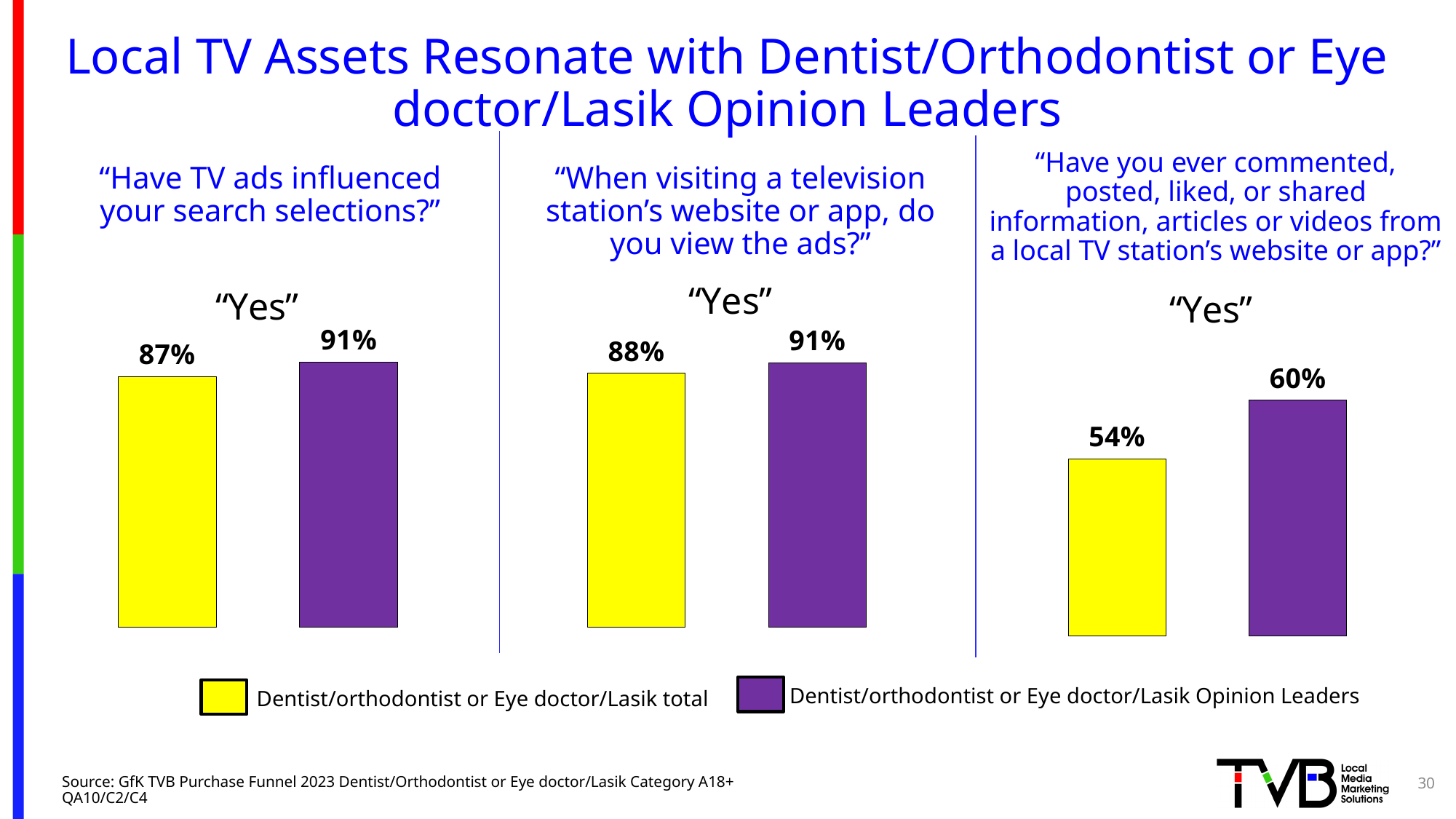
In the right chart ("Have you ever commented, posted, liked, or shared..."), what is the value for Dentist/orthodontist or Eye doctor/Lasik total? 54% In the middle chart ("When visiting a television station's website or app, do you view the ads?"), which group has the larger value: total or Opinion Leaders? Opinion Leaders In the middle chart ("When visiting a television station's website or app, do you view the ads?"), what is the value for Dentist/orthodontist or Eye doctor/Lasik total? 88% In the right chart ("Have you ever commented, posted, liked, or shared..."), which group has the lower value? Dentist/orthodontist or Eye doctor/Lasik total In the middle chart ("When visiting a television station's website or app, do you view the ads?"), what is the value for Dentist/orthodontist or Eye doctor/Lasik Opinion Leaders? 91% In the left chart ("Have TV ads influenced your search selections?"), what percentage of Dentist/orthodontist or Eye doctor/Lasik Opinion Leaders answered "Yes"? 91% In the left chart ("Have TV ads influenced your search selections?"), what percentage of Dentist/orthodontist or Eye doctor/Lasik total answered "Yes"? 87% In the left chart ("Have TV ads influenced your search selections?"), what is the difference between the Opinion Leaders value and the total value? 4 percentage points How many series does the legend at the bottom of the slide list? 2 In the right chart ("Have you ever commented, posted, liked, or shared..."), what is the value for Dentist/orthodontist or Eye doctor/Lasik Opinion Leaders? 60% In the right chart ("Have you ever commented, posted, liked, or shared..."), what is the difference between the Opinion Leaders value and the total value? 6 percentage points What kind of chart is used in each of the three panels on the slide? Bar chart